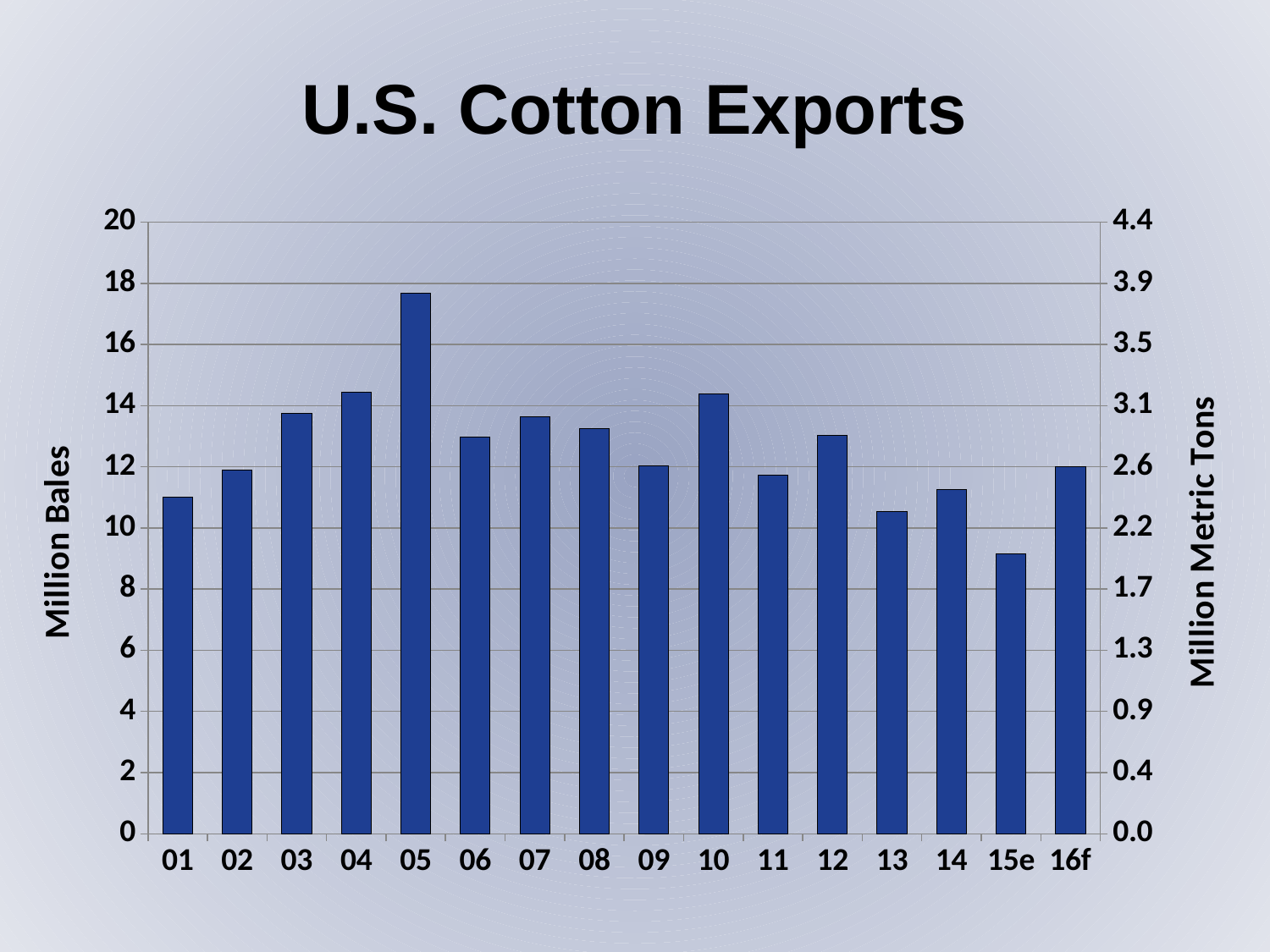
What is the title of the chart? U.S. Cotton Exports Is the value for 05 greater or less than 16 million bales? greater How many bars (years) are plotted in the chart? 16 What is the label of the right-hand vertical axis? Million Metric Tons Do the values rise or fall from 10 to 15e? fall overall, though not steadily (12 and 14 are higher than the preceding year) Is the value for 15e greater or less than 10 million bales? less Which year has higher exports, 05 or 13? 05 Which year has the highest cotton exports? 05 What kind of chart is shown on the slide? bar chart Is the value for 01 greater or less than 10 million bales? greater Which year has the lowest cotton exports? 15e